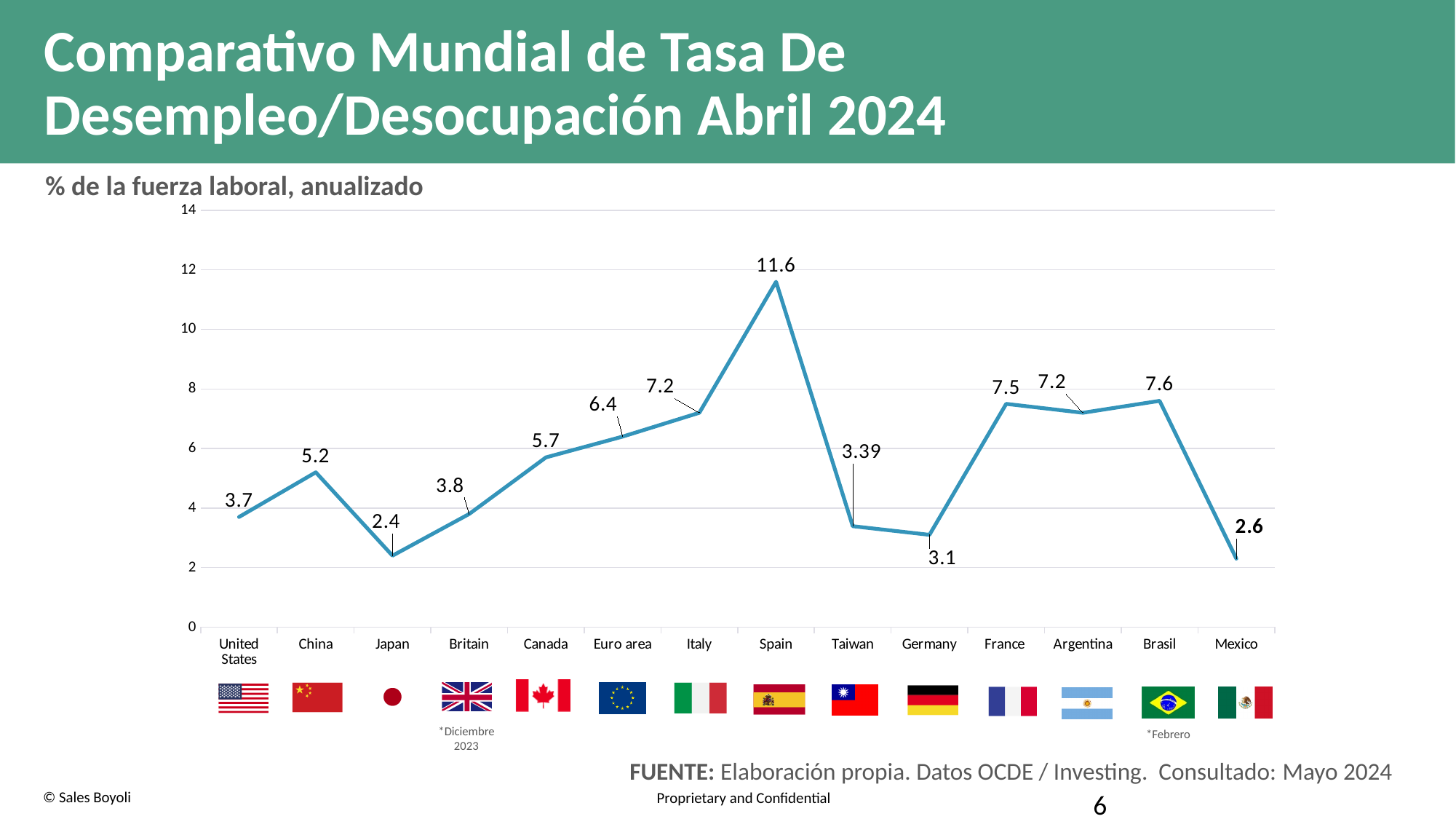
Do the values rise or fall from Taiwan to Germany? fall Which has a higher value, Brasil or France? Brasil What is the value shown for Mexico? 2.6 What is the value shown for Taiwan? 3.39 How many countries or regions are plotted on the chart? 14 What is the unemployment rate shown for Spain? 11.6 Which country has the lowest unemployment rate on the chart? Japan Is the value for Canada greater or less than 6? less What is the difference between the values for Spain and Japan? 9.2 What kind of chart is shown on the slide? line chart What unit is stated in the subtitle above the chart? % de la fuerza laboral, anualizado Which country has the highest unemployment rate on the chart? Spain